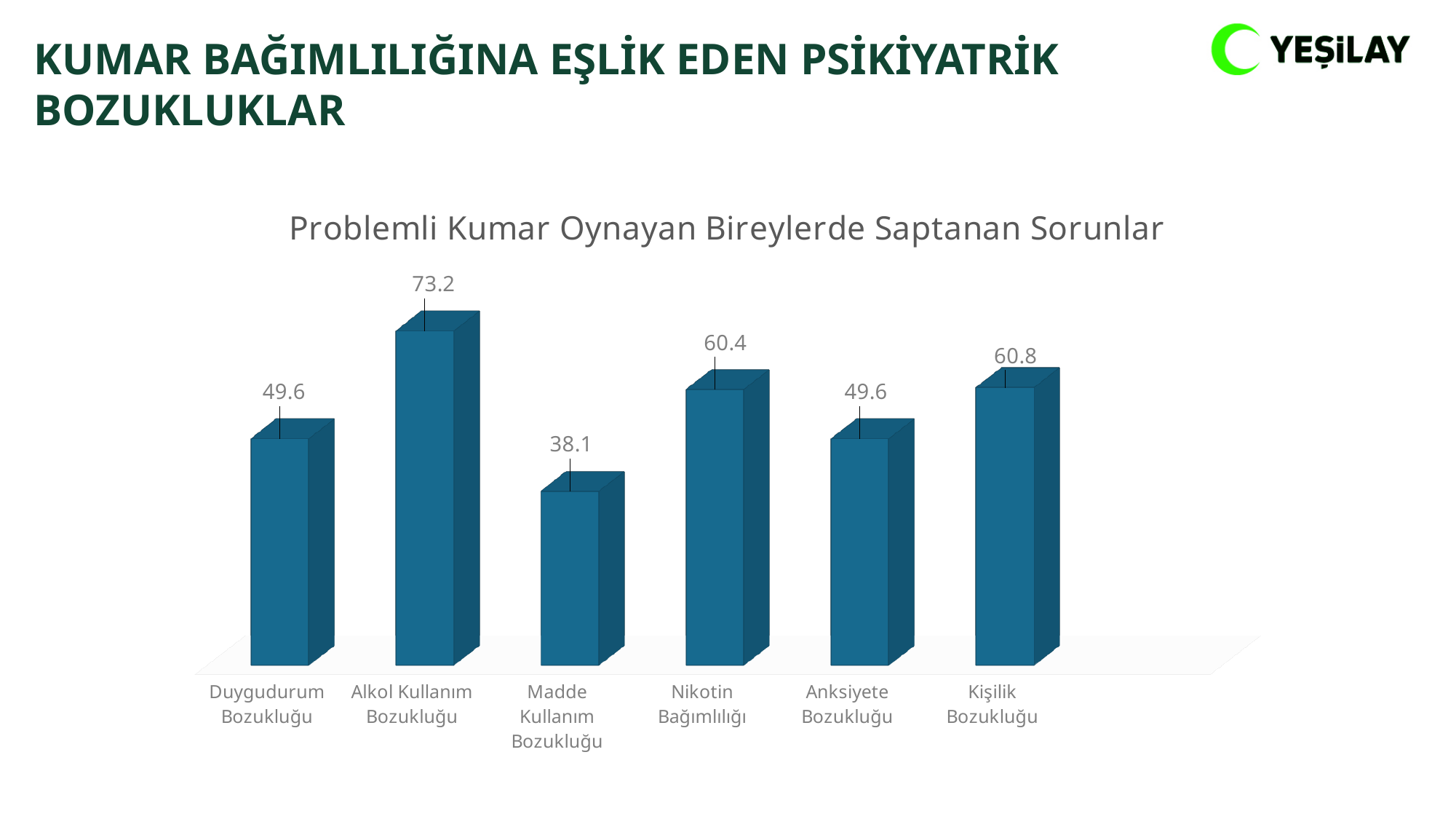
Which category has the highest value? Alkol Kullanım Bozukluğu What is the difference between the values for Alkol Kullanım Bozukluğu and Madde Kullanım Bozukluğu? 35.1 What is the value for Madde Kullanım Bozukluğu? 38.1 Which category has the lowest value? Madde Kullanım Bozukluğu What is the value for Nikotin Bağımlılığı? 60.4 What kind of chart is shown on the slide? Bar chart Which is larger, the value for Alkol Kullanım Bozukluğu or the value for Nikotin Bağımlılığı? Alkol Kullanım Bozukluğu What is the value for Kişilik Bozukluğu? 60.8 What is the difference between the values for Nikotin Bağımlılığı and Anksiyete Bozukluğu? 10.8 How many categories are shown in the chart? 6 What is the value for Alkol Kullanım Bozukluğu? 73.2 What is the title of the chart? Problemli Kumar Oynayan Bireylerde Saptanan Sorunlar